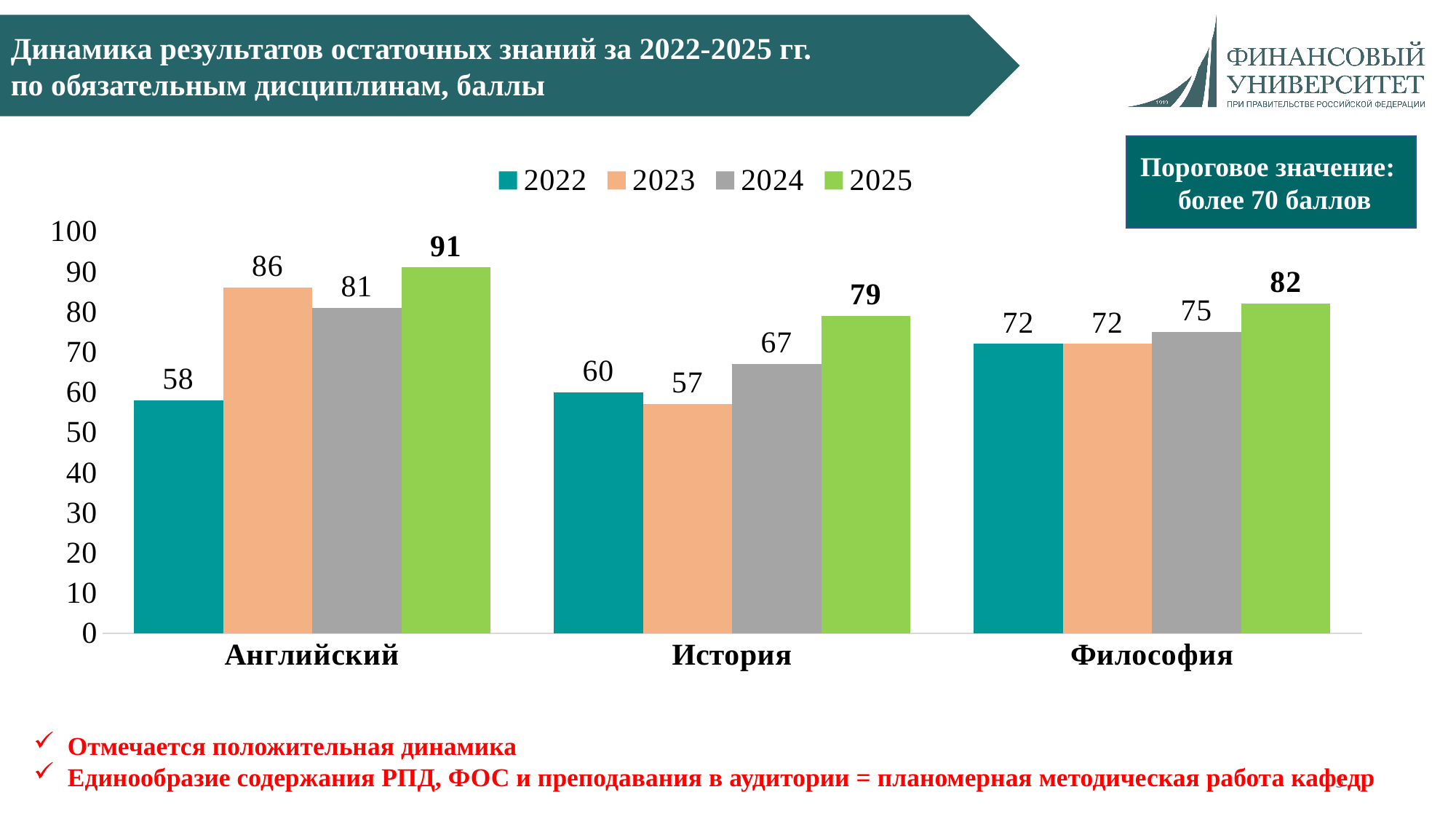
What is the difference between the 2025 and 2022 values for История? 19 What is the value for История in 2023? 57 Do the values for Философия rise or fall from 2022 to 2025? Rise What kind of chart is shown on the slide? Bar chart What is the value for Философия in 2024? 75 Which category has the highest value in 2025? Английский How many categories are shown on the x axis? 3 How many series does the legend list? 4 Which category has the lowest value in 2022? Английский What is the value for Английский in 2025? 91 What threshold value is stated in the box at the top right of the slide? более 70 баллов Which is larger: the 2023 value for Английский or the 2023 value for Философия? Английский